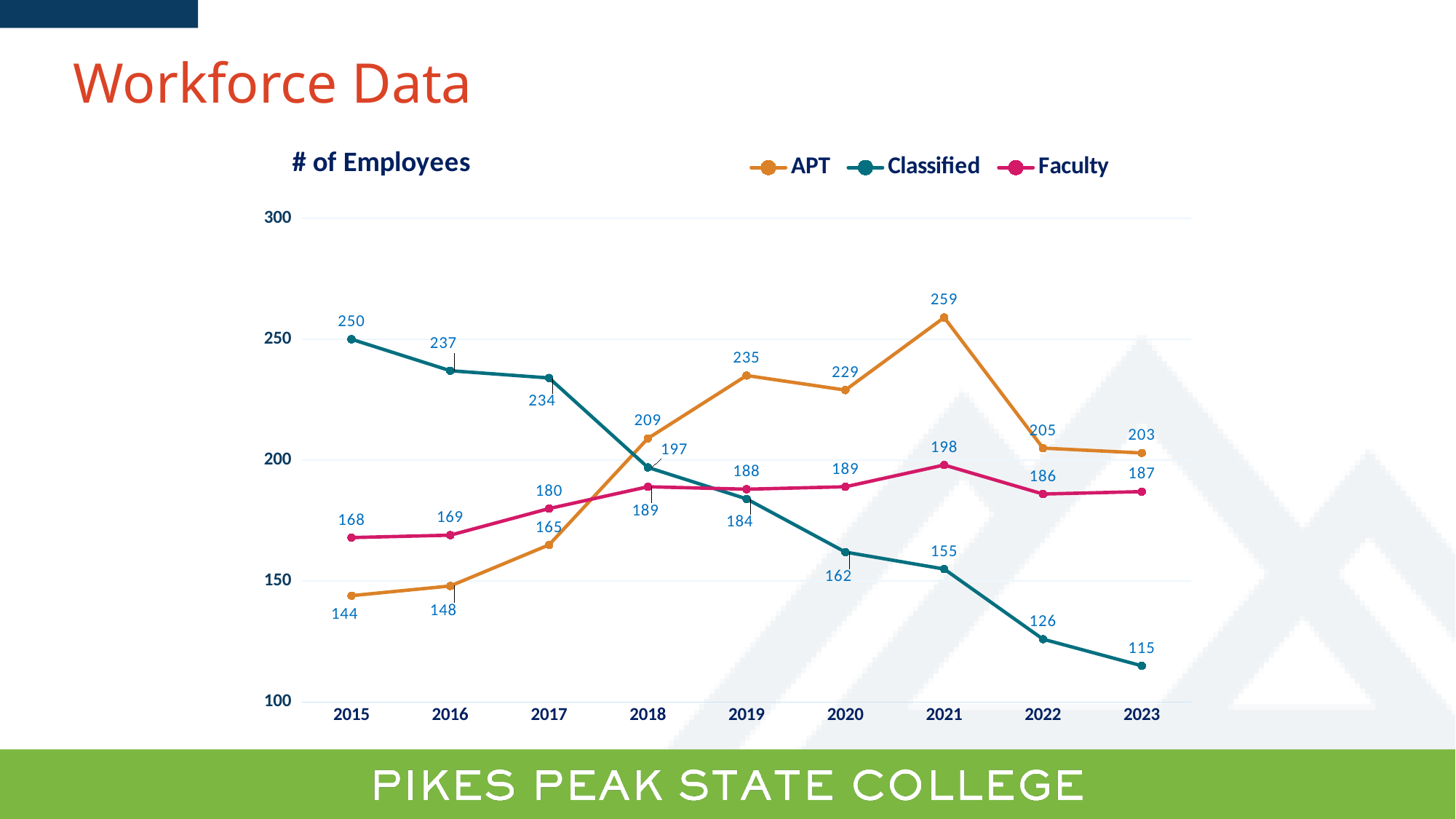
In which year is the Classified series at its lowest? 2023 What type of chart is shown on the slide? Line chart What is the number of APT employees in 2021? 259 What is the title shown above the chart's y axis? # of Employees What is the number of Classified employees in 2023? 115 Which series has the larger value in 2019, APT or Classified? APT What is the number of Faculty employees in 2017? 180 How many years are plotted along the x axis? 9 In which year is the APT series at its highest? 2021 Does the Classified series rise or fall from 2015 to 2023? Fall What is the difference between the Classified value in 2015 and in 2023? 135 How many series does the legend list? 3